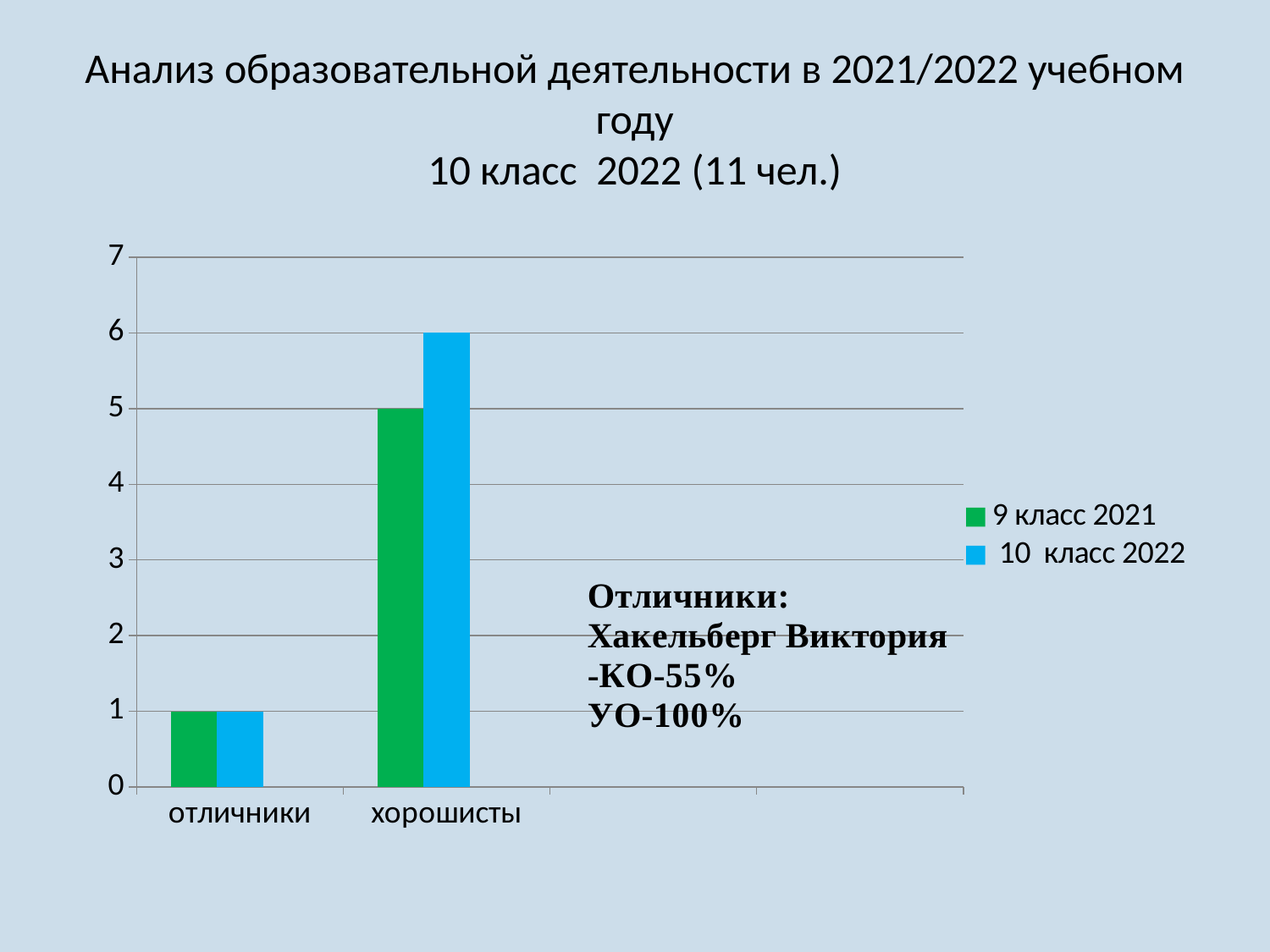
What is the difference between the 10 класс 2022 and 9 класс 2021 values for хорошисты? 1 What is the value for отличники in the 9 класс 2021 series? 1 Which category has the lowest value in the 9 класс 2021 series? отличники What is the value for отличники in the 10 класс 2022 series? 1 What kind of chart is shown on the slide? bar chart How many categories are shown on the x axis? 2 For хорошисты, which series has the larger value, 9 класс 2021 or 10 класс 2022? 10 класс 2022 Which series is shown in green in the legend? 9 класс 2021 How many series does the legend list? 2 Which category has the highest value in the 10 класс 2022 series? хорошисты What is the value for хорошисты in the 9 класс 2021 series? 5 What is the value for хорошисты in the 10 класс 2022 series? 6